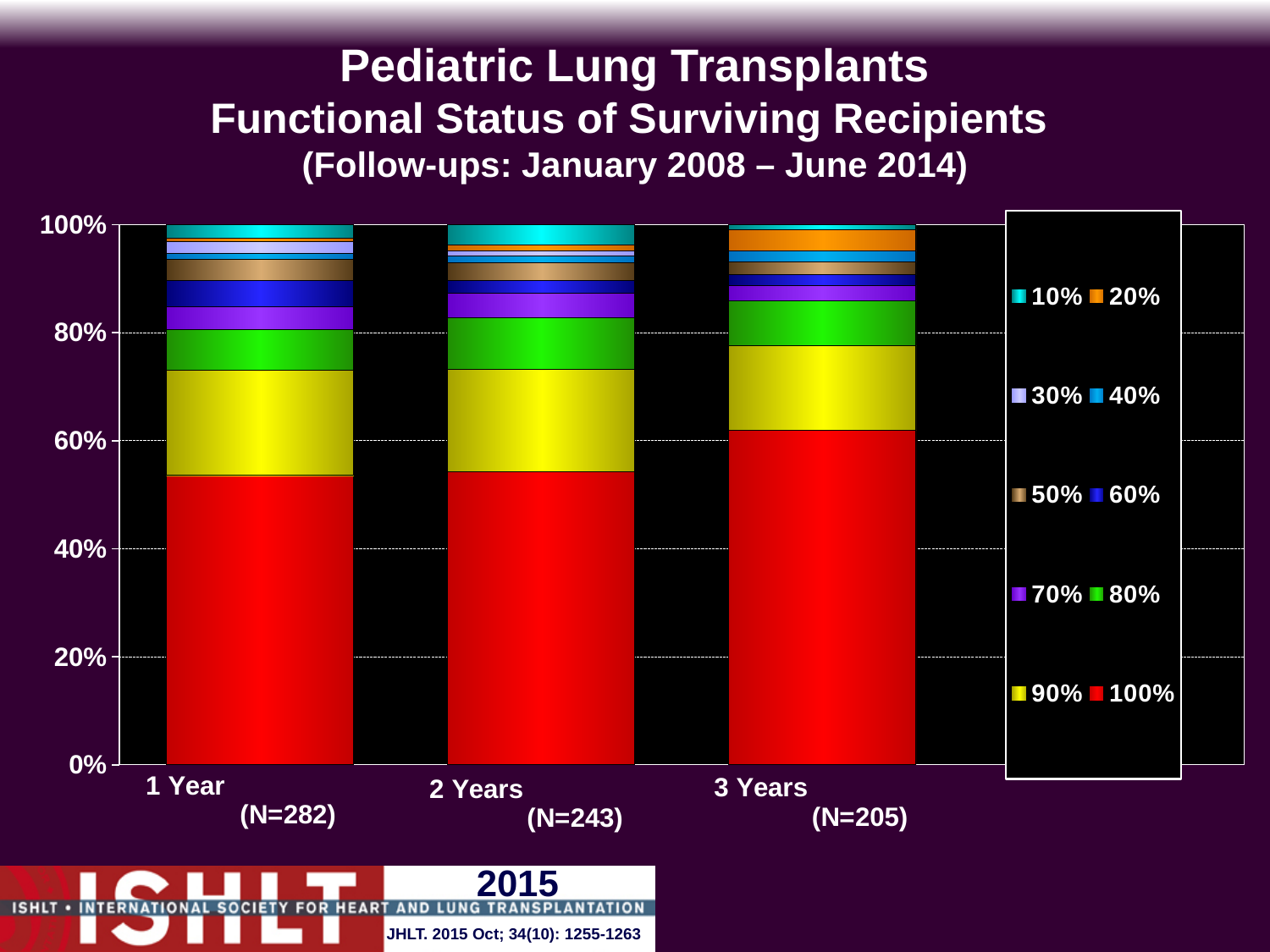
Is the share of recipients with 100% functional status at 3 Years greater or less than 40%? greater Is the 100% functional status segment larger at 1 Year or at 3 Years? 3 Years Which follow-up category has the largest 100% functional status segment? 3 Years What kind of chart is shown on the slide? stacked bar chart What is the sample size (N) shown for the 1 Year category? N=282 What is the sample size (N) shown for the 3 Years category? N=205 Does the share of recipients with 100% functional status rise or fall from 1 Year to 3 Years? rise How many series does the legend list? 10 Is the share of recipients with 100% functional status at 1 Year greater or less than 60%? less Is the share of recipients with 100% functional status at 1 Year greater or less than 40%? greater How many follow-up time categories are plotted on the x axis? 3